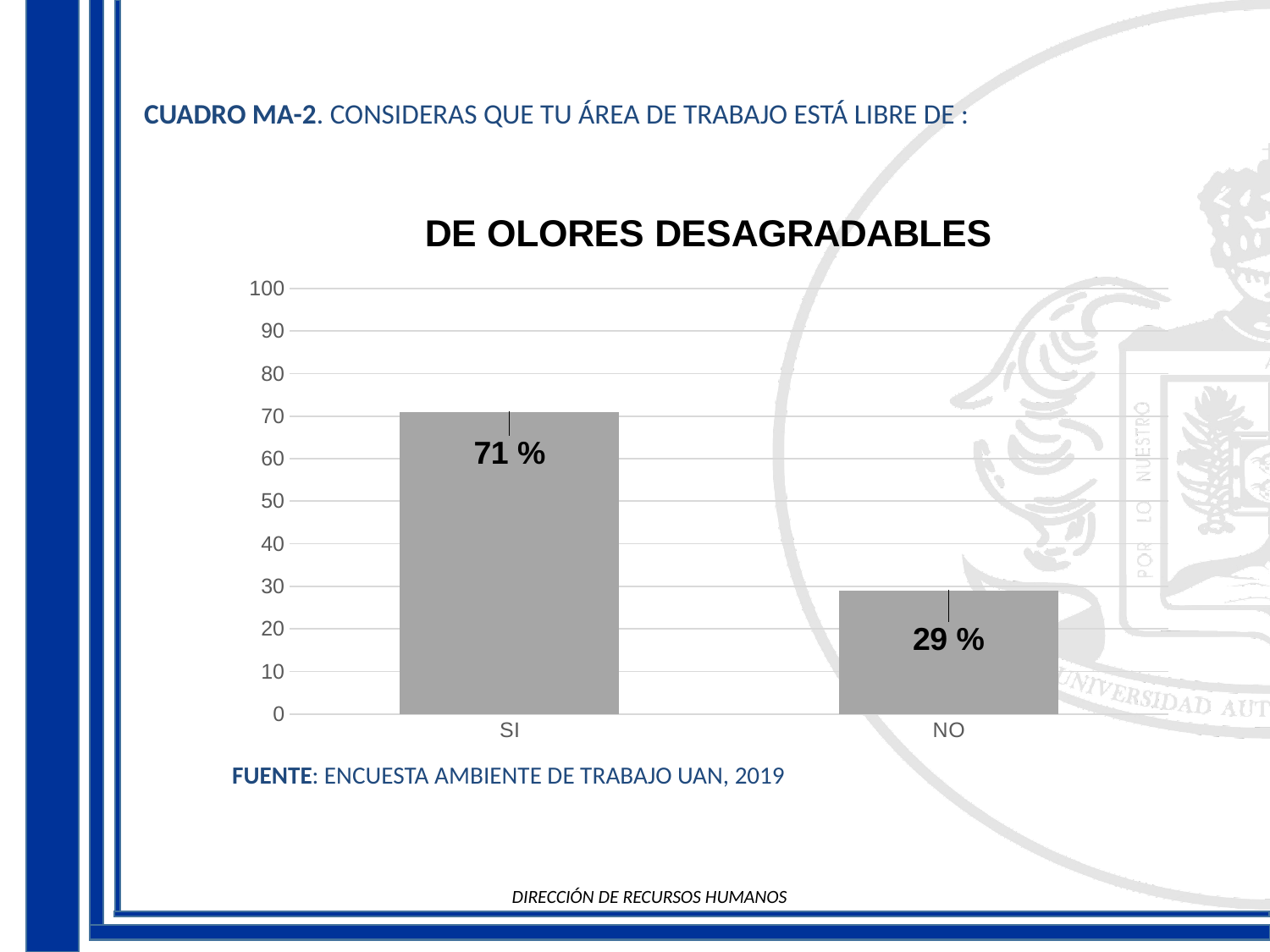
What is the value for NO? 29 % Which is larger, the value for SI or the value for NO? SI What is the highest value shown on the y axis? 100 Is the value for SI greater or less than 50? greater What is the difference between the values for SI and NO? 42 % Which category has the highest value? SI Is the value for NO greater or less than 40? less Which category has the lowest value? NO What is the value for SI? 71 % What kind of chart is shown? bar chart What is the title of the chart? DE OLORES DESAGRADABLES How many categories are shown on the x axis? 2